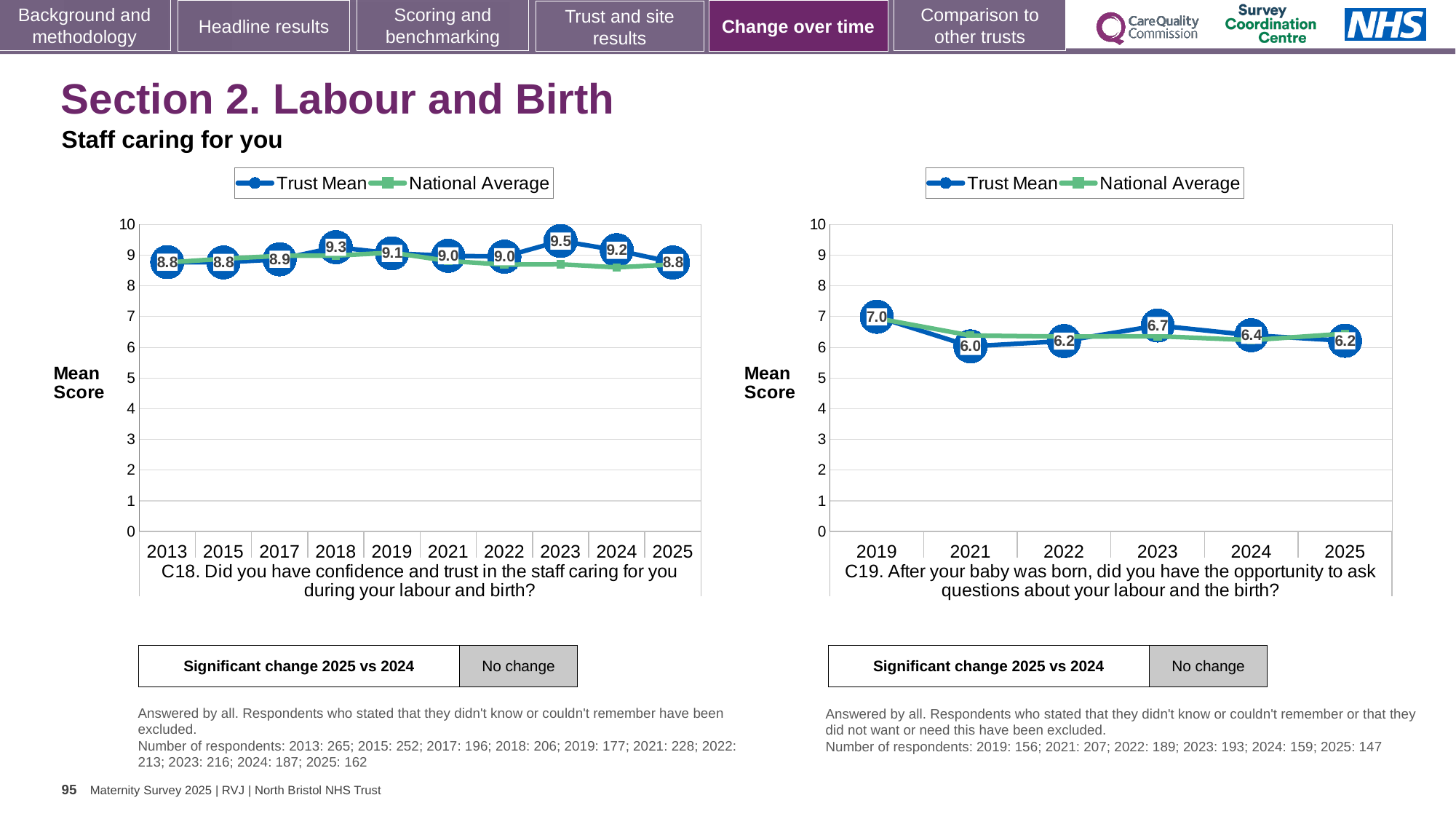
In the C19 chart (right), what is the difference between the Trust Mean for 2019 and 2025? 0.8 In the C18 chart (left), what is the Trust Mean for 2023? 9.5 In the C18 chart (left), how many years are plotted on the x axis? 10 In the C18 chart (left), what is the difference between the Trust Mean for 2023 and 2024? 0.3 In the C19 chart (right), what is the Trust Mean for 2019? 7.0 In the C19 chart (right), is the Trust Mean for 2023 or 2024 larger? 2023 In the C19 chart (right), which year has the lowest Trust Mean? 2021 In the C19 chart (right), is the National Average for 2019 greater or less than 6? greater In the C18 chart (left), which year has the highest Trust Mean? 2023 In the C18 chart (left), what is the Trust Mean for 2025? 8.8 How many series does the legend of the C19 chart (right) list? 2 What kind of chart is the C18 chart (left)? Line chart